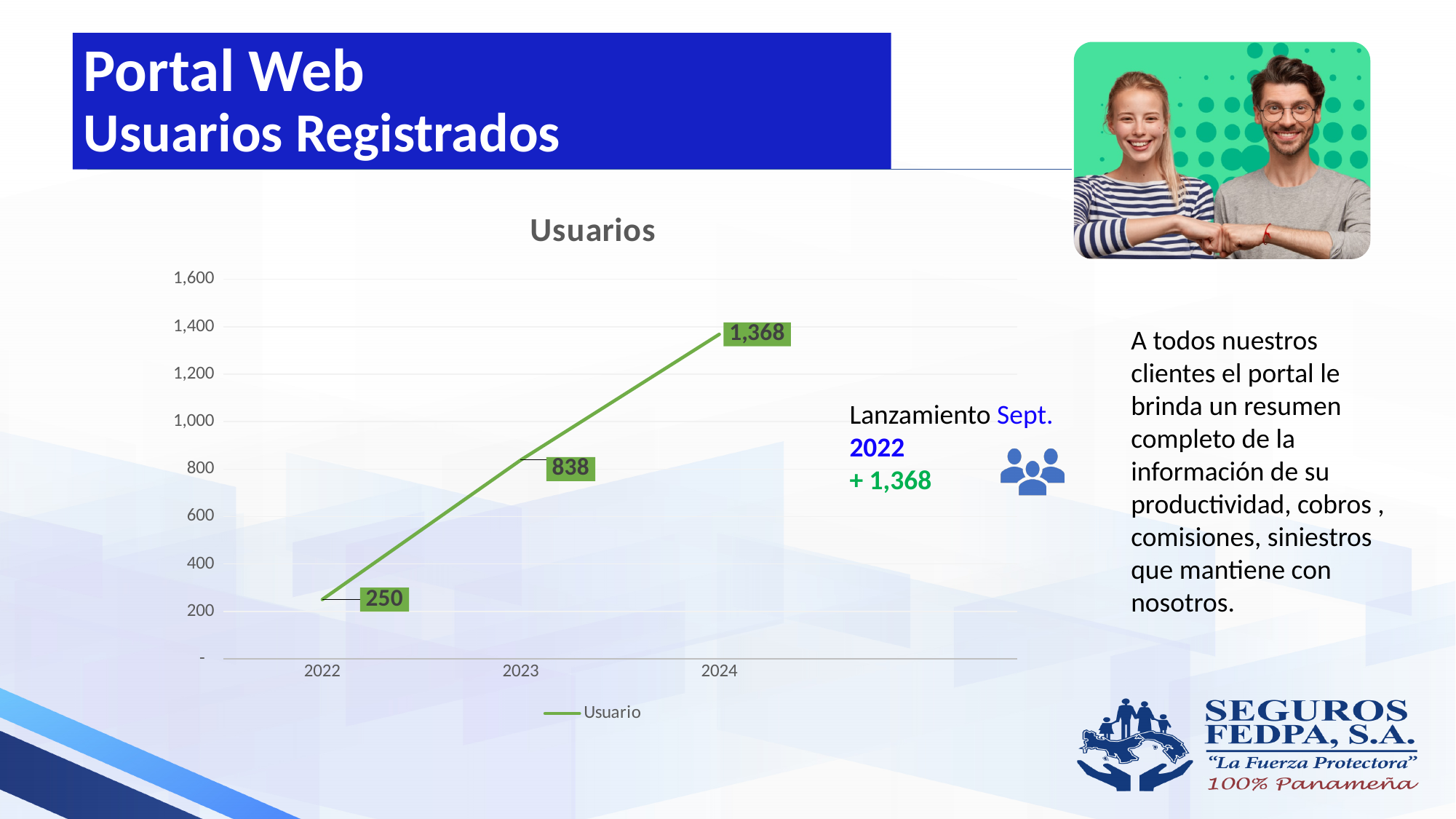
What kind of chart is the Usuarios chart? line chart How many series does the legend of the Usuarios chart list? 1 What is the value for 2023 in the Usuarios chart? 838 What is the difference between the 2023 and 2022 values in the Usuarios chart? 588 What is the value for 2024 in the Usuarios chart? 1,368 Is the value for 2023 greater or less than 1,000? less What is the value for 2022 in the Usuarios chart? 250 Which year has the highest value in the Usuarios chart? 2024 What is the difference between the 2024 and 2023 values in the Usuarios chart? 530 How many years are plotted on the x axis of the Usuarios chart? 3 Do the values rise or fall from 2022 to 2024 in the Usuarios chart? rise Which year has the lowest value in the Usuarios chart? 2022